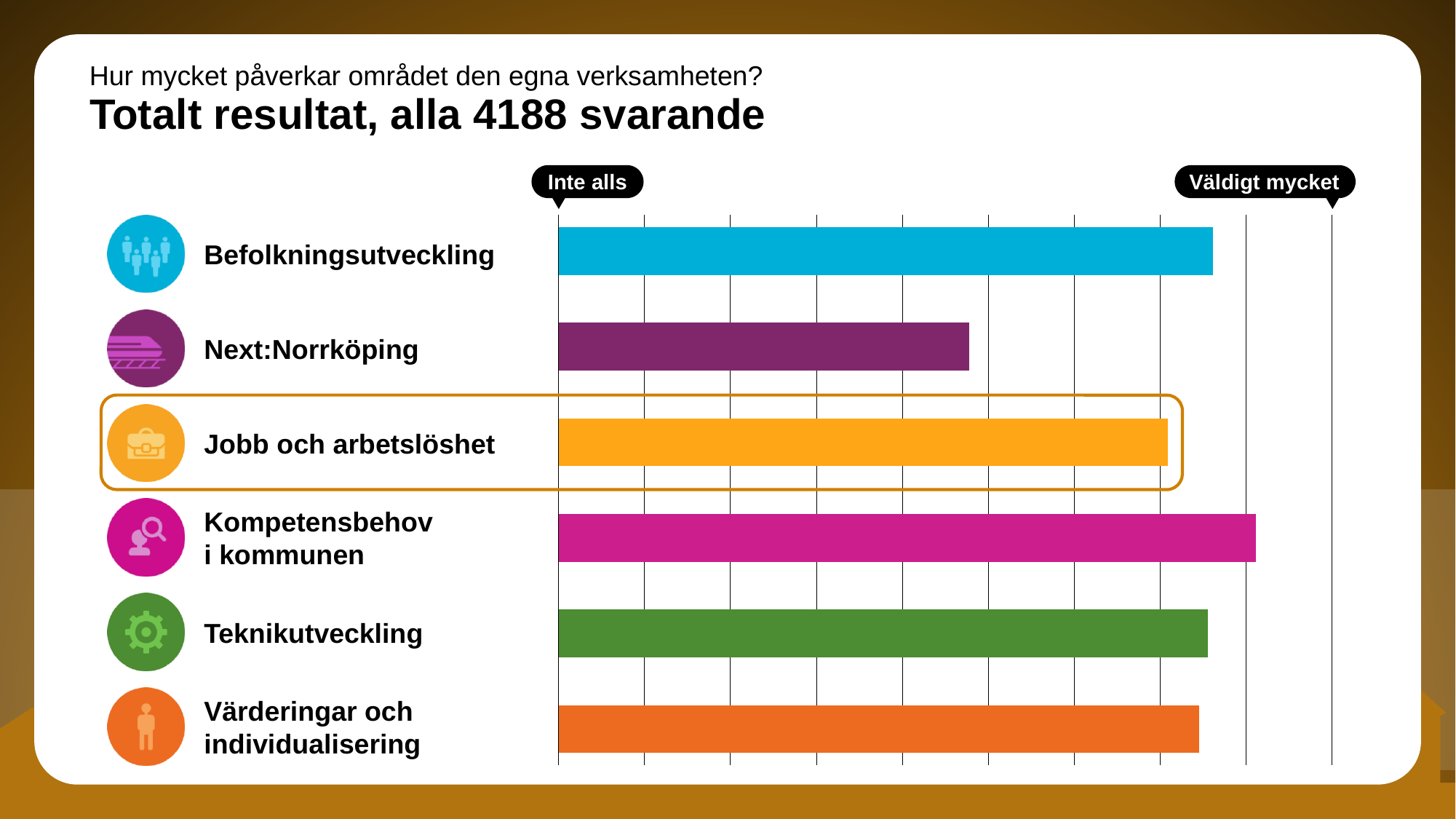
Which category has the longest bar? Kompetensbehov i kommunen Which bar is longer, Kompetensbehov i kommunen or Jobb och arbetslöshet? Kompetensbehov i kommunen How many categories are plotted in the chart? 6 Which category has the shortest bar? Next:Norrköping What are the two labels at the ends of the horizontal axis? Inte alls and Väldigt mycket Which bar is longer, Next:Norrköping or Jobb och arbetslöshet? Jobb och arbetslöshet Which bar is longer, Kompetensbehov i kommunen or Teknikutveckling? Kompetensbehov i kommunen Which category is highlighted with an outlined box on the slide? Jobb och arbetslöshet What kind of chart is shown on the slide? Bar chart